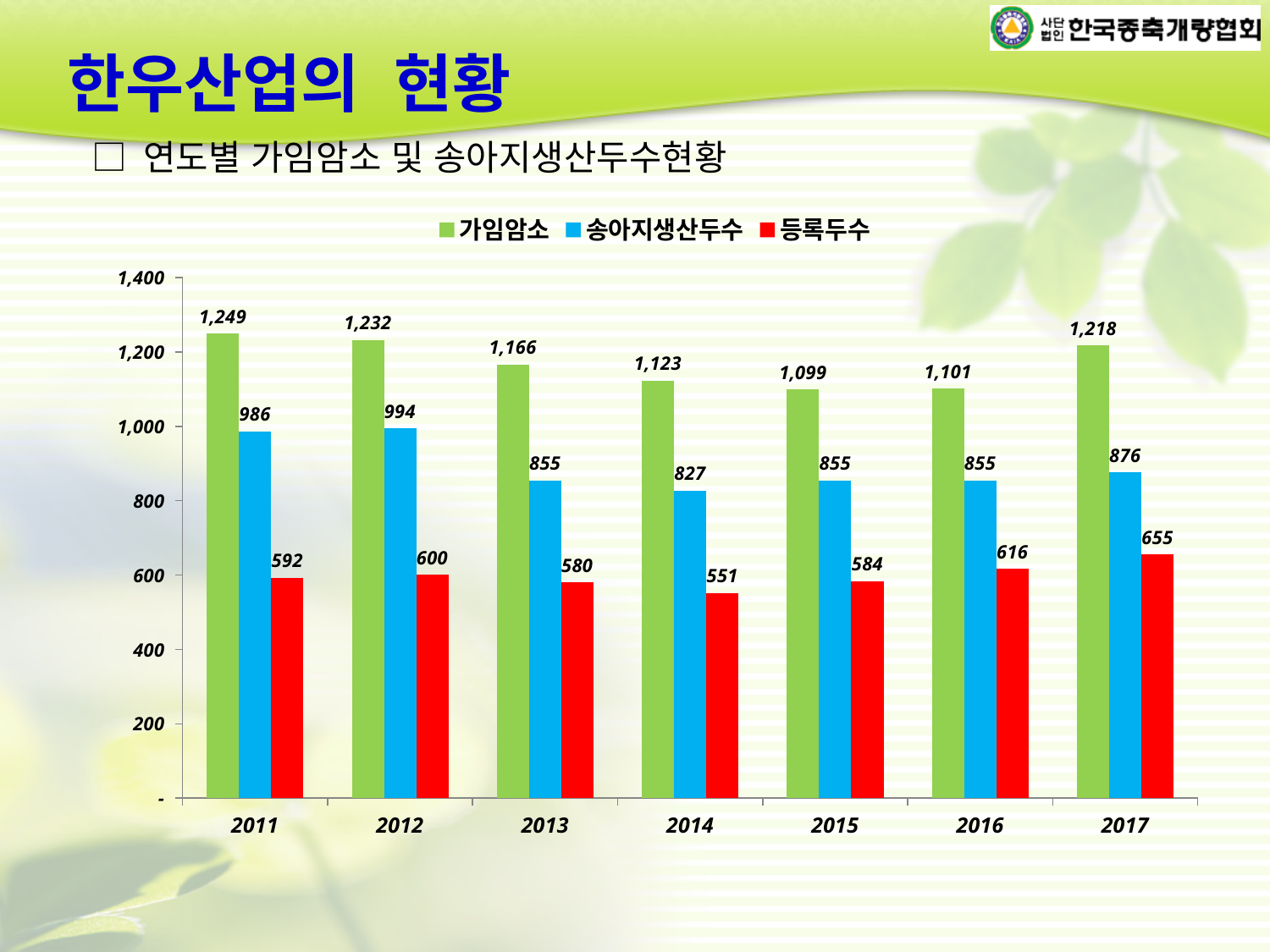
What is the difference between 가임암소 and 송아지생산두수 in 2017? 342 How many years are shown on the x axis? 7 Does 송아지생산두수 rise or fall from 2011 to 2014? fall What is the value of 송아지생산두수 in 2014? 827 Which colour represents 등록두수 in the legend? red In which year is 가임암소 lowest? 2015 In which year is 등록두수 highest? 2017 What is the value of 가임암소 in 2011? 1,249 What is the value of 등록두수 in 2016? 616 What kind of chart is shown on the slide? bar chart How many series does the legend list? 3 Which is larger: 등록두수 in 2012 or 등록두수 in 2014? 2012